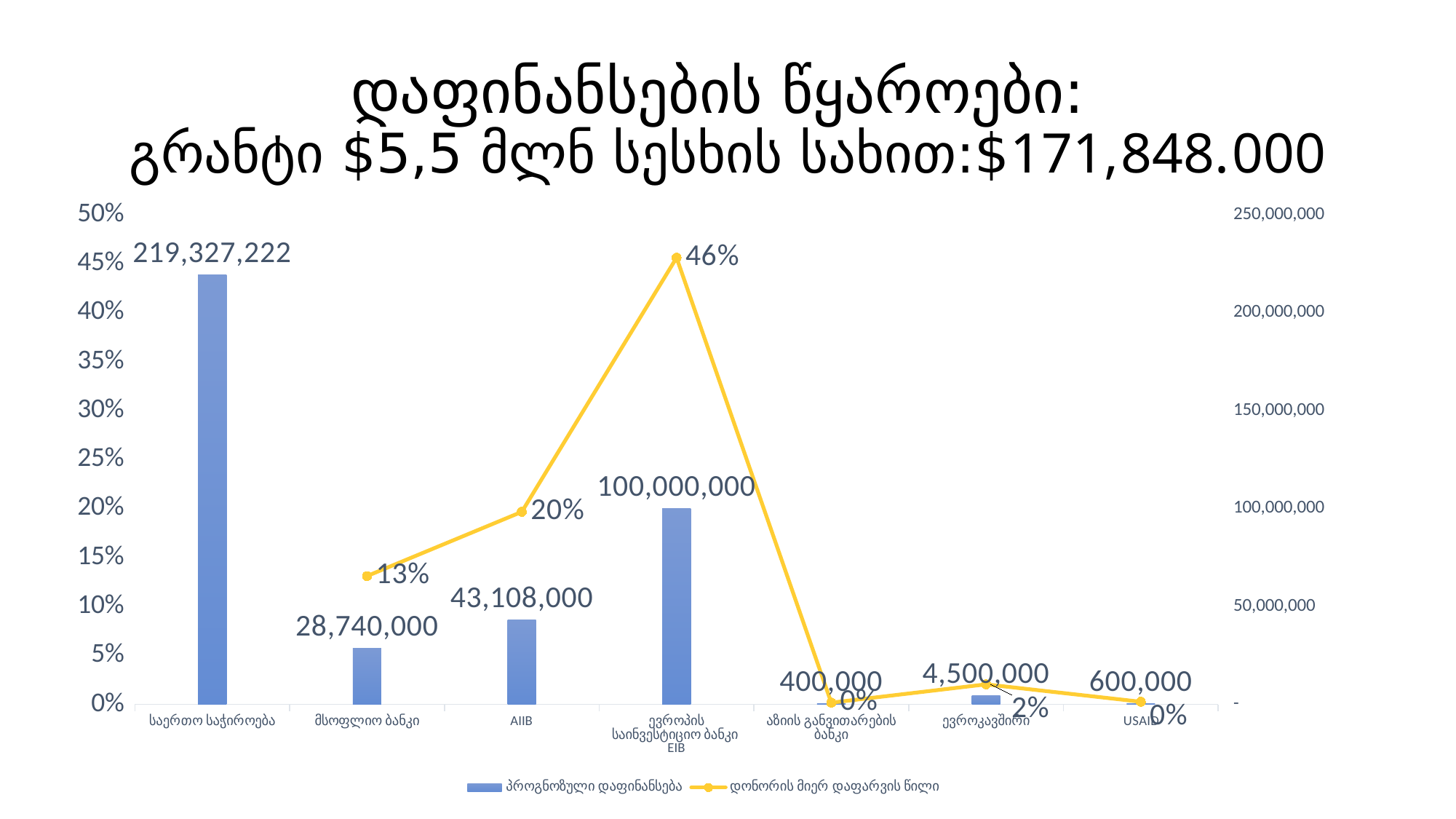
How many series does the legend list? 2 How many categories are shown on the x axis? 7 What is the projected financing value for მსოფლიო ბანკი? 28,740,000 What is the projected financing (პროგნოზული დაფინანსება) value for AIIB? 43,108,000 Which category has the highest projected financing bar? საერთო საჭიროება What is the donor coverage share for ევროკავშირი? 2% What kind of chart is shown on the slide? Combined bar and line chart What is the projected financing value for USAID? 600,000 Which has a larger donor coverage share, AIIB or მსოფლიო ბანკი? AIIB Which category has the lowest projected financing bar? აზიის განვითარების ბანკი What is the donor coverage share (დონორის მიერ დაფარვის წილი) for ევროპის საინვესტიციო ბანკი EIB? 46% What is the difference between the projected financing for AIIB and for მსოფლიო ბანკი? 14,368,000